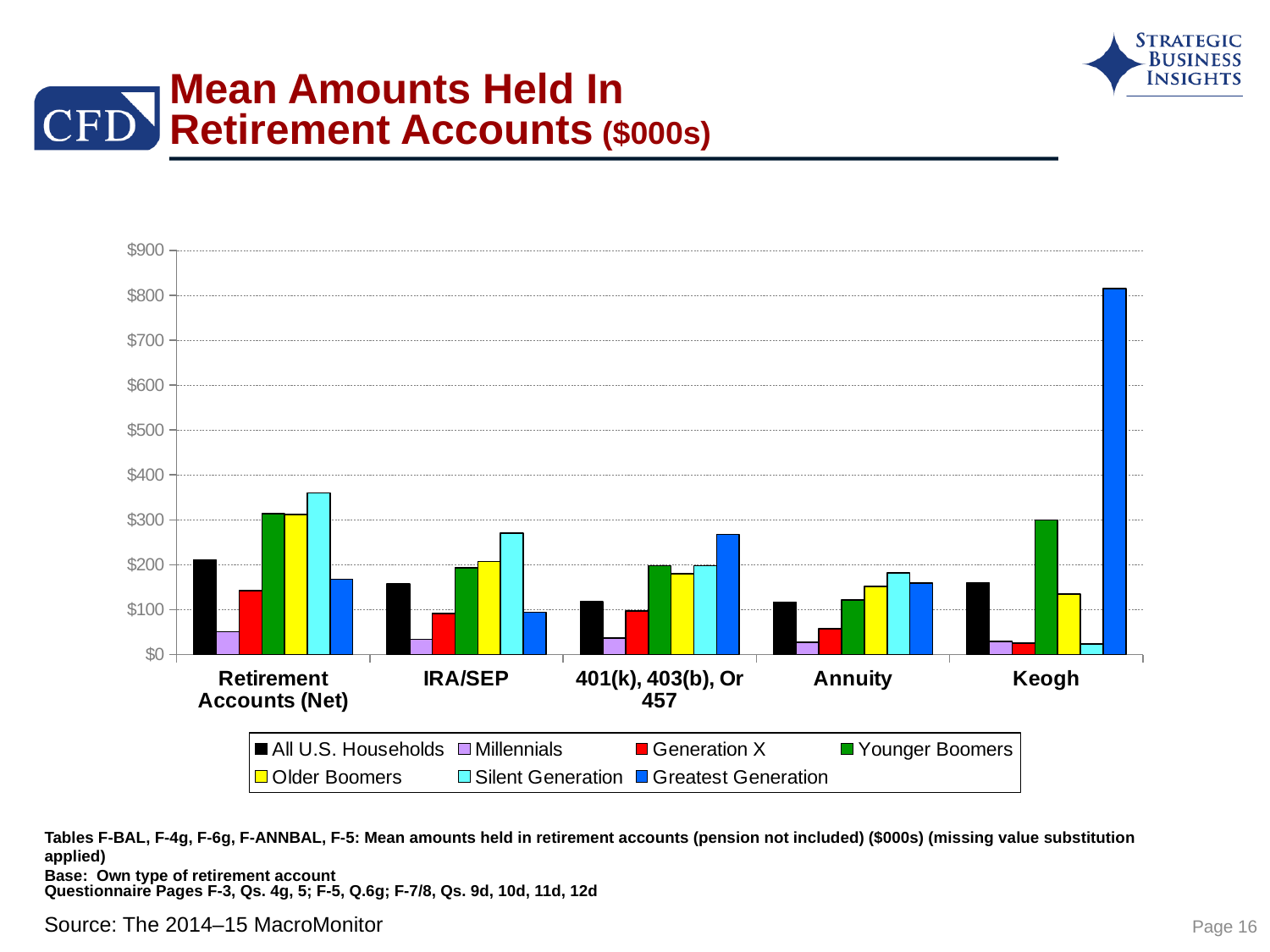
What kind of chart is shown on the slide? bar chart How many series does the legend list? 7 Is the Greatest Generation value for Keogh greater or less than $700? greater Is the Silent Generation value for Retirement Accounts (Net) greater or less than $300? greater For IRA/SEP, which is larger: Silent Generation or Greatest Generation? Silent Generation Within Retirement Accounts (Net), which series has the lowest value? Millennials Is the Younger Boomers value for Keogh greater or less than $200? greater For which account category is the Greatest Generation bar the highest? Keogh What unit is stated in the chart title for the amounts shown? $000s How many account categories are shown along the x axis? 5 For Keogh, which is larger: Younger Boomers or Older Boomers? Younger Boomers